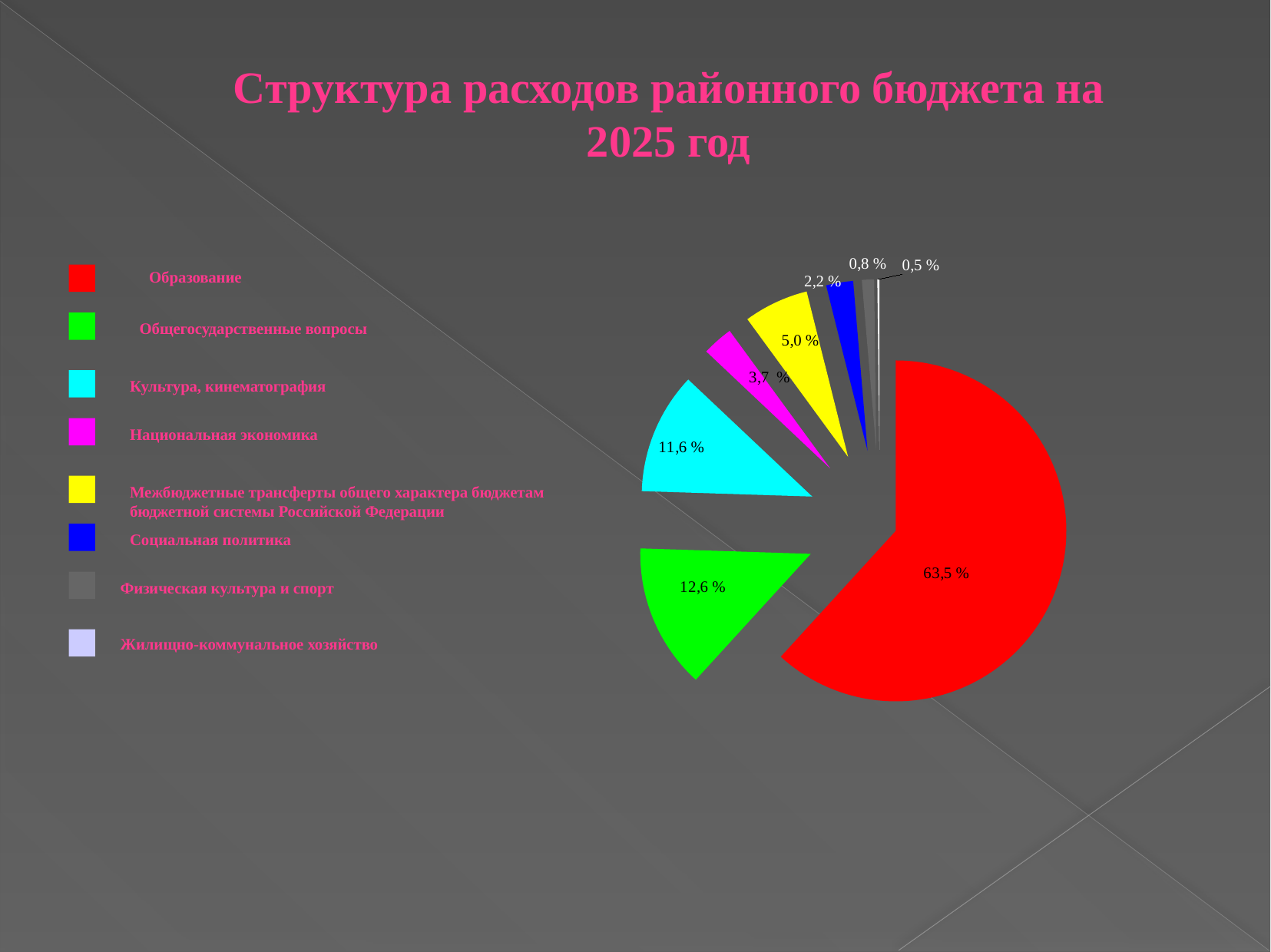
What is the difference between the shares of Общегосударственные вопросы and Культура, кинематография? 1,0 % Which is larger: the share for Межбюджетные трансферты общего характера or the share for Национальная экономика? Межбюджетные трансферты общего характера What is the value shown for Общегосударственные вопросы? 12,6 % Which category has the smallest share of the pie? Жилищно-коммунальное хозяйство Which category has the largest share of the pie? Образование What is the value shown for Национальная экономика? 3,7 % What is the value shown for Социальная политика? 2,2 % What share of the 2025 district budget expenditure goes to Образование? 63,5 % What is the value shown for Жилищно-коммунальное хозяйство? 0,5 % What type of chart is shown on the slide? pie chart What is the value shown for Культура, кинематография? 11,6 % How many categories does the pie chart contain? 8